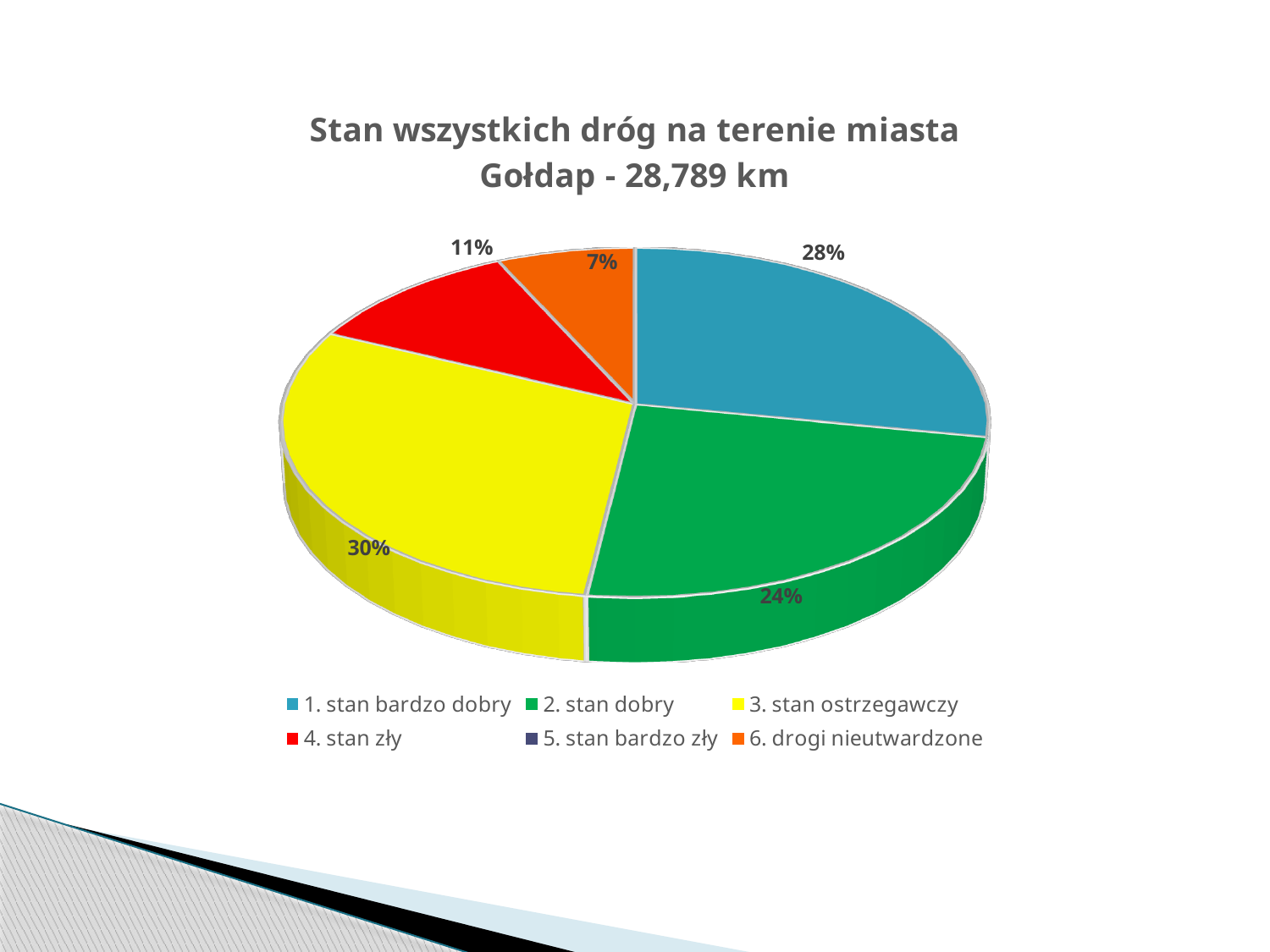
What is the total length of roads given in the chart title? 28,789 km What colour is the slice for "2. stan dobry"? Green What percentage of roads is in the category "1. stan bardzo dobry"? 28% How many categories does the legend list? 6 What is the difference in percentage points between "1. stan bardzo dobry" and "2. stan dobry"? 4 Which category has the largest slice of the pie? 3. stan ostrzegawczy Which labelled slice is the smallest in the pie chart? 6. drogi nieutwardzone What share does "6. drogi nieutwardzone" have in the pie chart? 7% What share does "4. stan zły" have in the pie chart? 11% Which is larger: the share for "2. stan dobry" or the share for "4. stan zły"? 2. stan dobry What percentage of roads is in the category "3. stan ostrzegawczy"? 30% What type of chart is shown on the slide? Pie chart